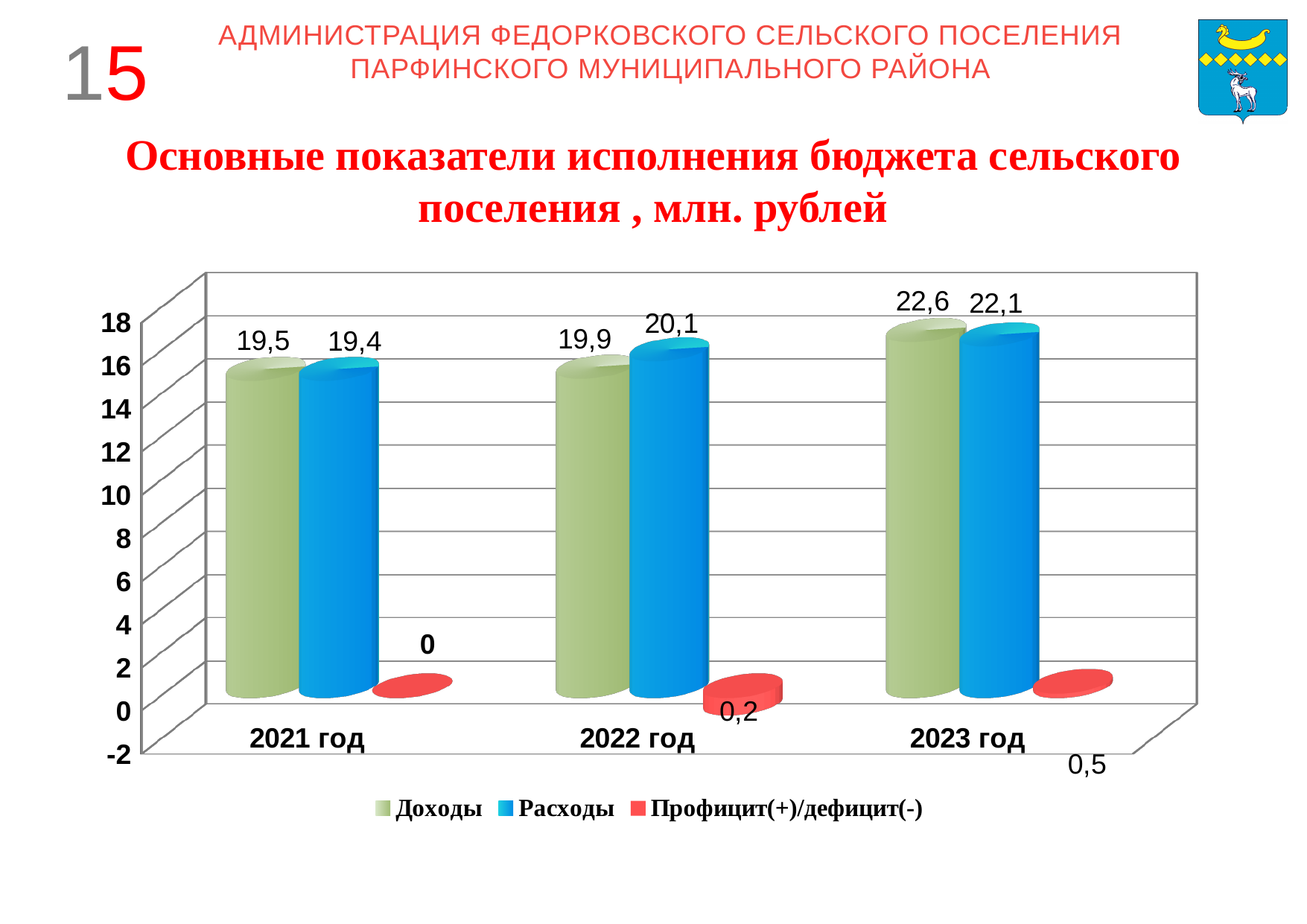
What is the difference between Доходы and Расходы in 2023 год? 0,5 What is the value of Расходы for 2022 год? 20,1 What is the value of Профицит(+)/дефицит(-) for 2021 год? 0 What is the value of Доходы for 2023 год? 22,6 What kind of chart is shown on the slide? Bar chart Which is larger in 2022 год, Доходы or Расходы? Расходы How many years are shown on the x axis? 3 What is the value of Доходы for 2021 год? 19,5 In which year is Доходы the highest? 2023 год In which year is Расходы the lowest? 2021 год What is the value of Профицит(+)/дефицит(-) for 2023 год? 0,5 How many series does the legend list? 3